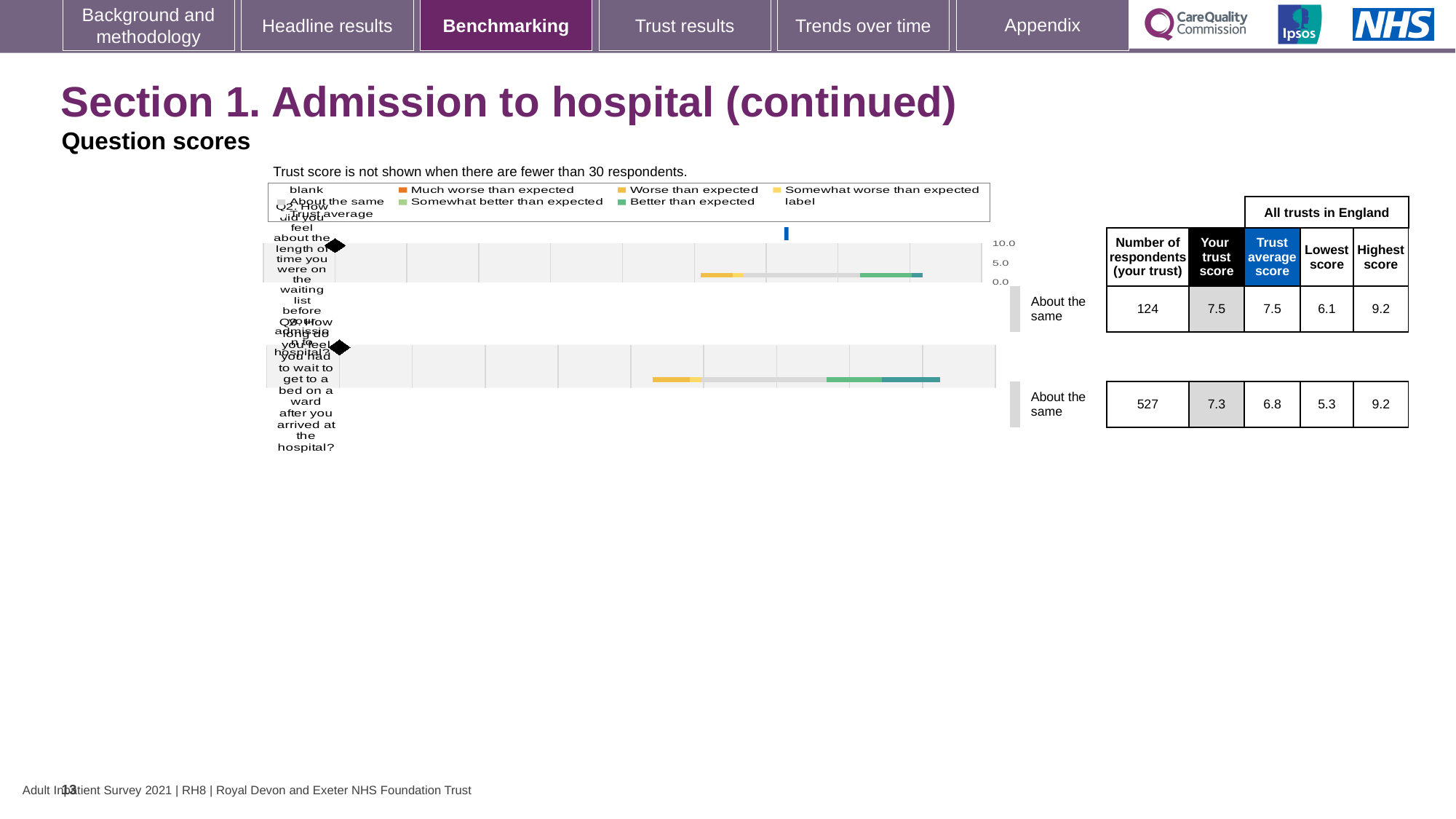
What kind of chart is used to show the question scores? Bar chart What is the trust average score across all trusts in England for Q3? 6.8 For Q3, how much higher is the trust's score than the trust average score? 0.5 What benchmark category is shown for Q2? About the same What is the highest score across all trusts in England for Q3? 9.2 How many respondents from the trust answered Q2? 124 What is the trust score for Q2 (how did you feel about the length of time you were on the waiting list before admission)? 7.5 How many questions are plotted on this slide? 2 How many respondents from the trust answered Q3? 527 What is the lowest score across all trusts in England for Q2? 6.1 Which question has the higher trust score, Q2 or Q3? Q2 What is the trust score for Q3 (how long did you feel you had to wait to get to a bed on a ward after you arrived at the hospital)? 7.3